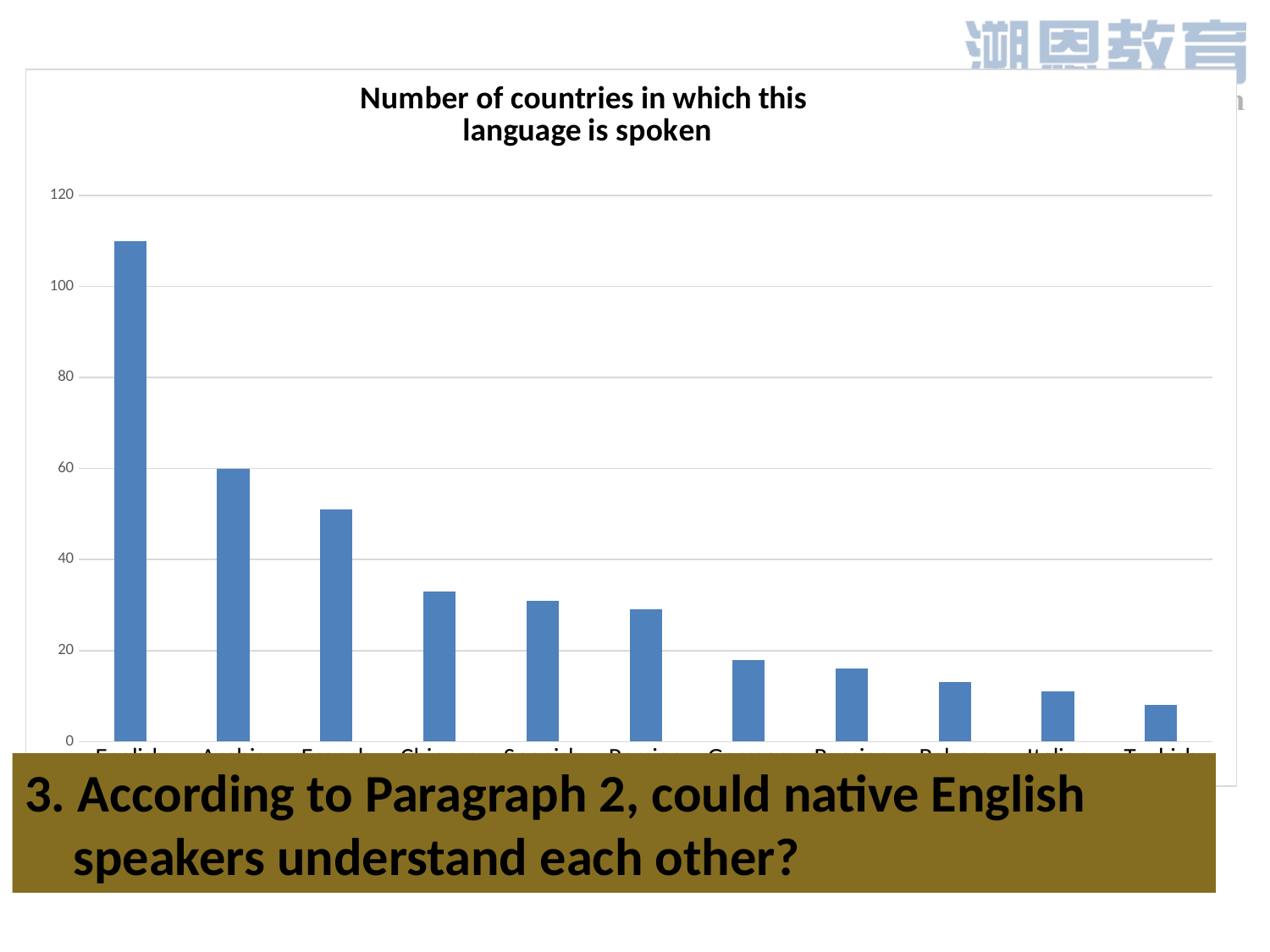
Is the value of the rightmost bar greater or less than 20? less Which bar is the lowest in the chart? the rightmost bar Do the bar values rise or fall from left to right across the chart? fall Which is larger, the third bar from the left or the fourth bar from the left? the third bar from the left What is the title of the chart? Number of countries in which this language is spoken What kind of chart is shown on the slide? bar chart Is the value of the second bar from the left greater or less than 80? less Which bar is the highest in the chart? the leftmost bar (English) Is the value of the fourth bar from the left greater or less than 40? less How many bars (languages) are plotted in the chart? 11